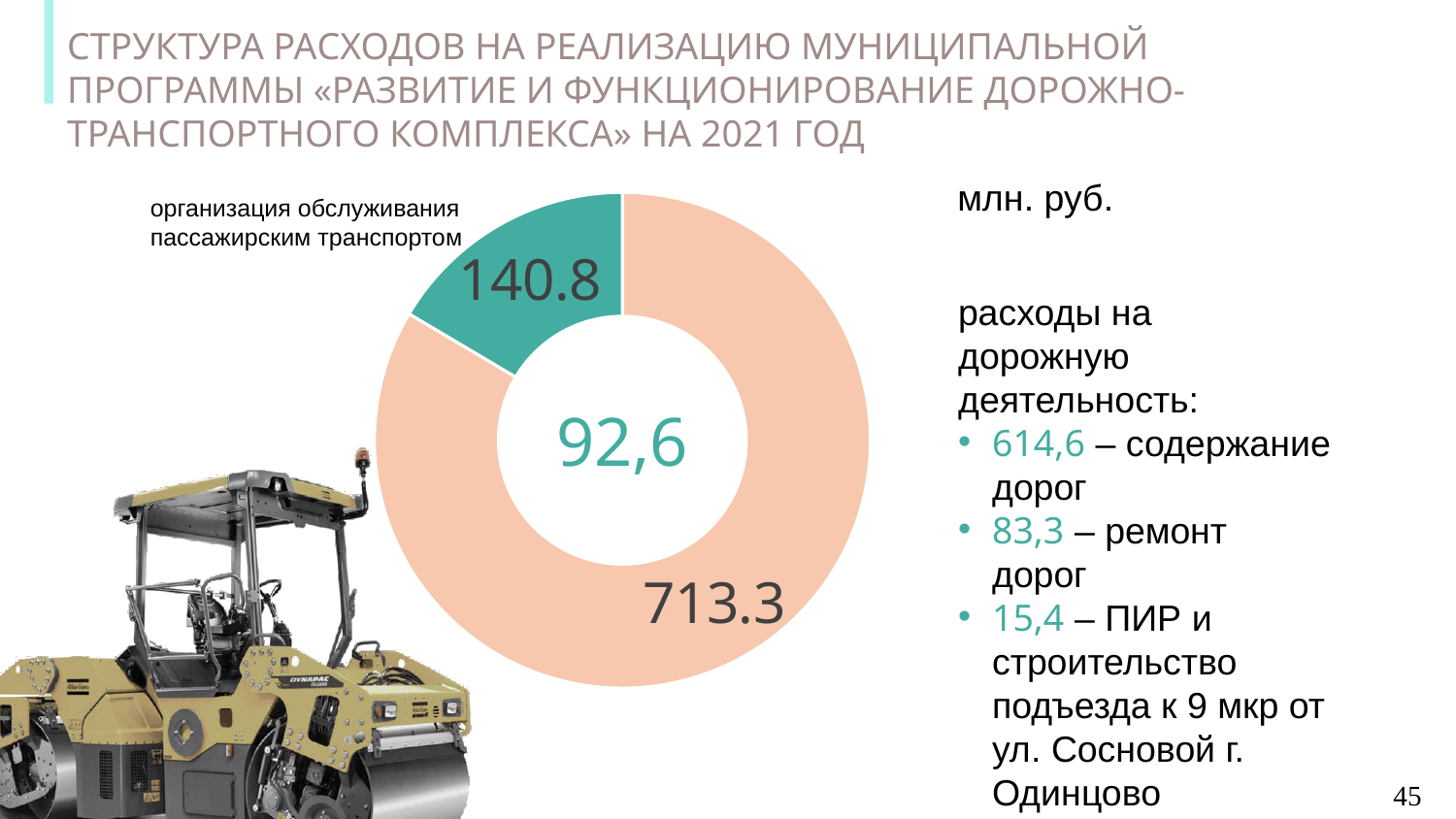
Which is larger: the slice for «организация обслуживания пассажирским транспортом» or the peach slice? the peach slice (713.3) What value is printed on the large peach-coloured slice of the doughnut chart? 713.3 Which slice of the doughnut chart is the largest? the peach slice labelled 713.3 How many slices does the doughnut chart have? 2 Which slice of the doughnut chart is the smallest? организация обслуживания пассажирским транспортом (140.8) What is the total of the two slice values shown on the doughnut chart? 854.1 What is the value of the slice labelled «организация обслуживания пассажирским транспортом»? 140.8 In what units are the chart values given, according to the slide? млн. руб. What colour is the slice for «организация обслуживания пассажирским транспортом»? teal (green) What is the difference between the two slice values, 713.3 and 140.8? 572.5 What kind of chart is shown on the slide? doughnut (pie) chart